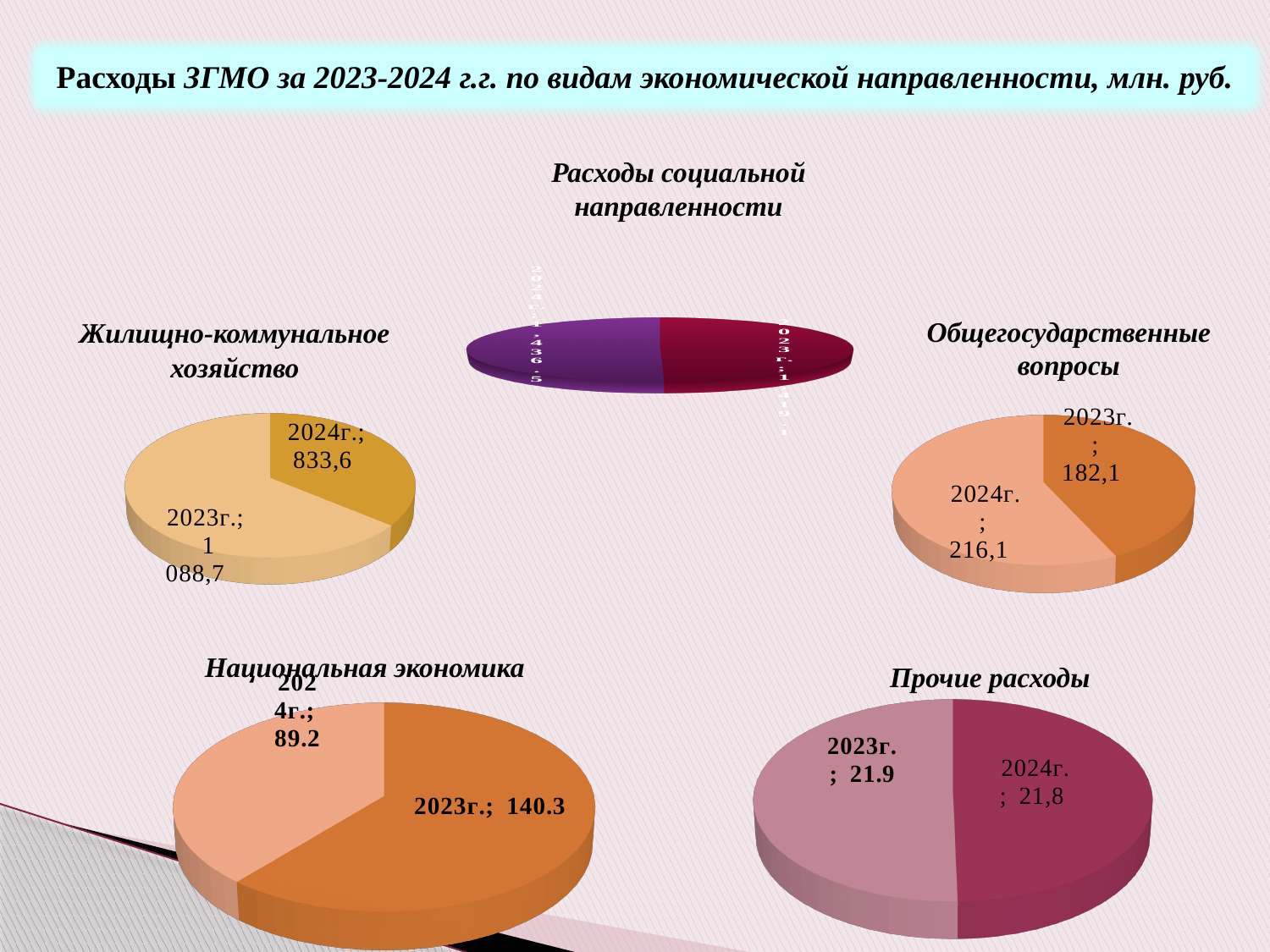
In the 'Общегосударственные вопросы' pie chart, what is the value for 2023г.? 182,1 In the 'Общегосударственные вопросы' pie chart, which year has the larger value, 2023г. or 2024г.? 2024г. In the 'Национальная экономика' pie chart, what is the value for 2023г.? 140.3 In the 'Национальная экономика' pie chart, what is the difference between the 2023г. and 2024г. values? 51.1 In the 'Жилищно-коммунальное хозяйство' pie chart, which year has the larger value, 2023г. or 2024г.? 2023г. In the 'Прочие расходы' pie chart, what is the value for 2024г.? 21,8 In the 'Общегосударственные вопросы' pie chart, what is the difference between the 2024г. and 2023г. values? 34,0 What type of chart is used for 'Прочие расходы'? Pie chart How many pie charts are shown on the slide? 5 In the 'Жилищно-коммунальное хозяйство' pie chart, what is the value for 2023г.? 1 088,7 In the 'Общегосударственные вопросы' pie chart, what is the value for 2024г.? 216,1 In the 'Жилищно-коммунальное хозяйство' pie chart, what is the value for 2024г.? 833,6